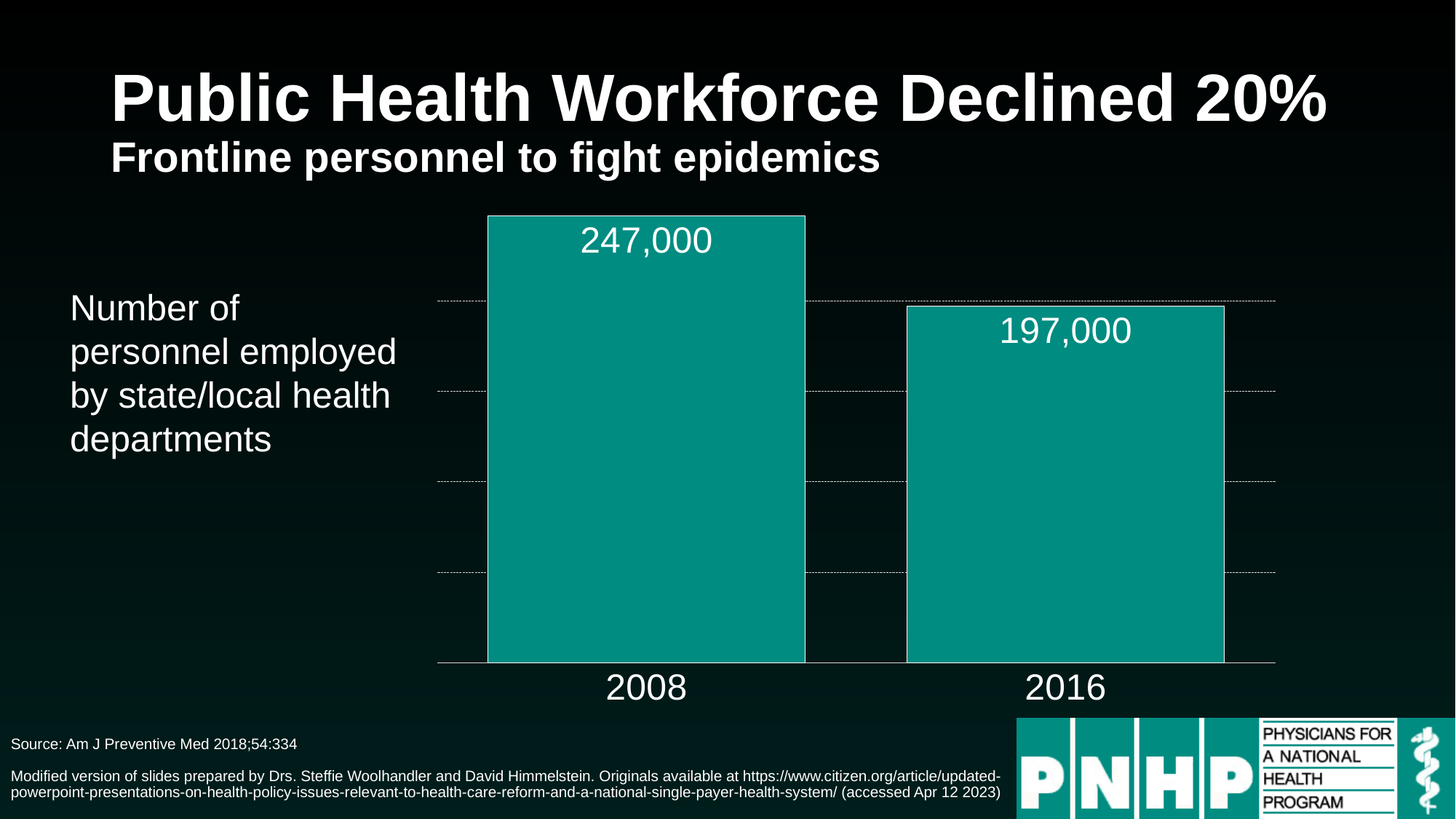
What is the number of personnel employed by state/local health departments in 2008? 247,000 How many years are shown on the x axis? 2 Which year has the lower number of personnel? 2016 What colour are the bars in the chart? teal Is the value for 2008 larger or smaller than the value for 2016? larger Do the values rise or fall from 2008 to 2016? fall What is the difference between the 2008 and 2016 values? 50,000 What is the title of the slide? Public Health Workforce Declined 20% Which year has the higher number of personnel? 2008 What kind of chart is shown on the slide? bar chart What is the number of personnel employed by state/local health departments in 2016? 197,000